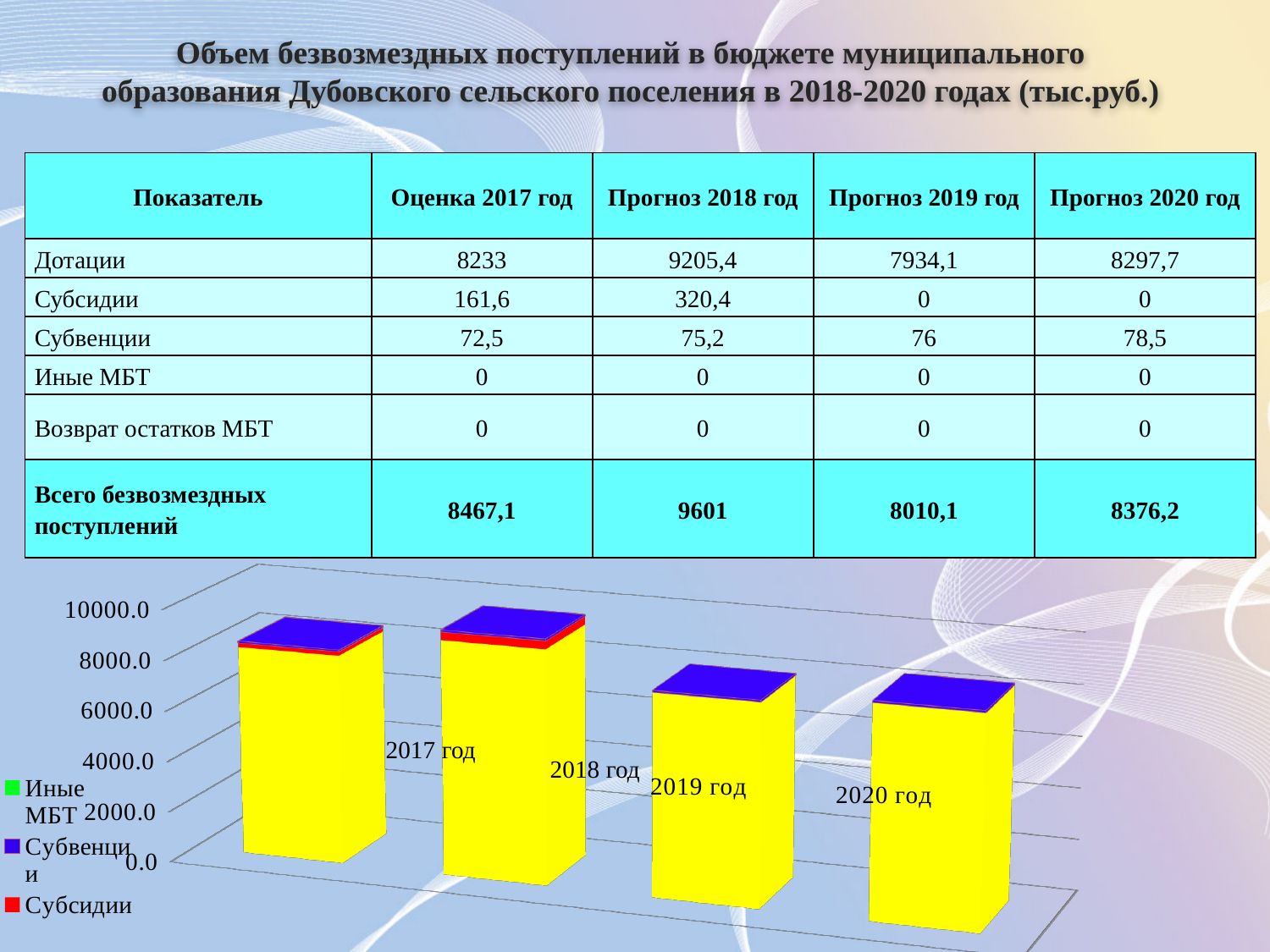
What colour represents Субсидии in the chart legend? red Is the total height of the 2018 год bar greater or less than 8000.0? greater Which bar is taller in the chart, 2018 год or 2019 год? 2018 год Which bar is taller in the chart, 2017 год or 2018 год? 2018 год Is the total height of the 2019 год bar greater or less than 10000.0? less Is the total height of the 2018 год bar greater or less than 10000.0? less Which year has the tallest bar in the chart? 2018 год Does the total bar height rise or fall from 2018 год to 2019 год? fall What kind of chart is shown at the bottom of the slide? bar chart What colour represents Субвенции in the chart legend? blue How many year categories are plotted along the x axis of the chart? 4